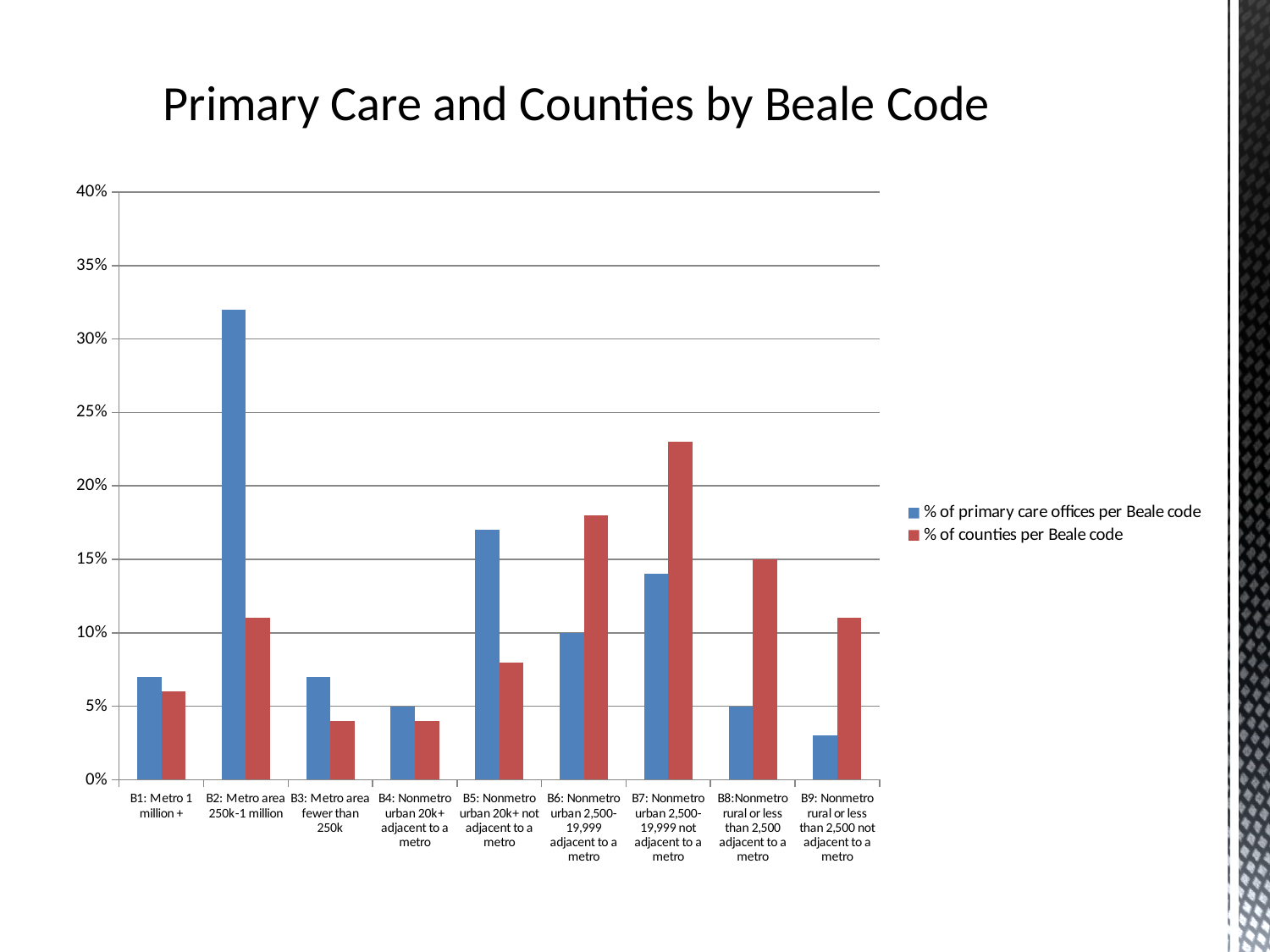
Which Beale code has the highest % of counties? B7: Nonmetro urban 2,500-19,999 not adjacent to a metro Is the % of primary care offices for B2: Metro area 250k-1 million greater or less than 30%? greater Is the % of counties for B7: Nonmetro urban 2,500-19,999 not adjacent to a metro greater or less than 20%? greater Is the % of primary care offices for B9: Nonmetro rural or less than 2,500 not adjacent to a metro greater or less than 5%? less Which Beale code has the highest % of primary care offices? B2: Metro area 250k-1 million What is the title of the chart? Primary Care and Counties by Beale Code Which Beale code has the lowest % of primary care offices? B9: Nonmetro rural or less than 2,500 not adjacent to a metro What kind of chart is shown on the slide? bar chart For B6: Nonmetro urban 2,500-19,999 adjacent to a metro, which is larger: % of primary care offices or % of counties? % of counties per Beale code For B5: Nonmetro urban 20k+ not adjacent to a metro, which is larger: % of primary care offices or % of counties? % of primary care offices per Beale code How many series does the legend list? 2 How many Beale code categories are shown on the x axis? 9